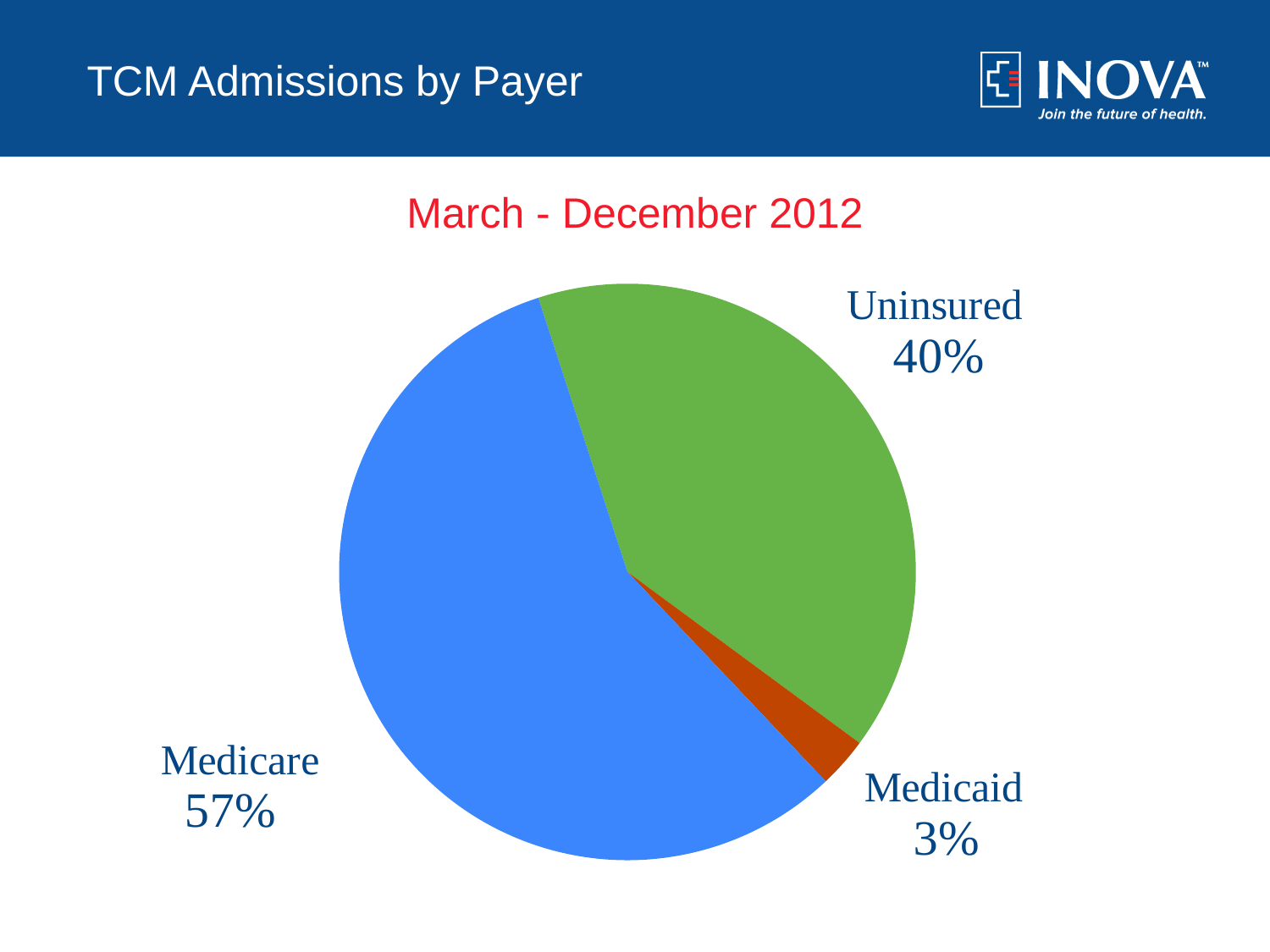
What is the difference in percentage points between the Medicare and Uninsured shares? 17 Which payer has the smallest share of TCM admissions? Medicaid What share of TCM admissions is Medicare? 57% How many payer categories are shown in the pie chart? 3 What time period does the chart cover? March - December 2012 What share of TCM admissions is Uninsured? 40% Which payer has the largest share of TCM admissions? Medicare What colour is the Uninsured slice? Green What share of TCM admissions is Medicaid? 3% Which is larger, the Medicare share or the Uninsured share? Medicare What is the difference in percentage points between the Uninsured and Medicaid shares? 37 What kind of chart is shown on the slide? Pie chart